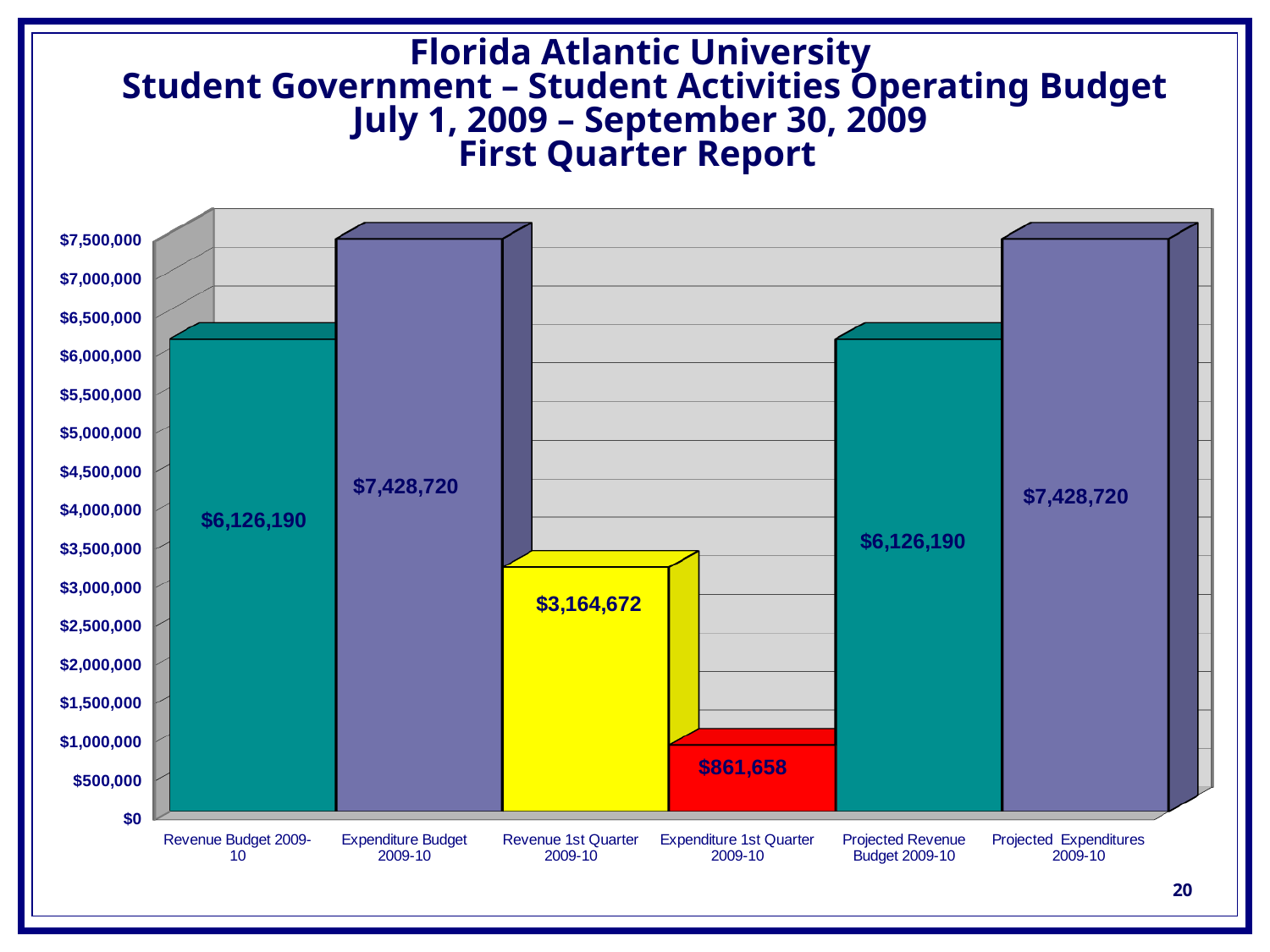
What is the value for Expenditure 1st Quarter 2009-10? $861,658 Which category has the lowest value? Expenditure 1st Quarter 2009-10 What colour is the bar for Revenue 1st Quarter 2009-10? yellow What kind of chart is shown on the slide? bar chart What is the difference between Expenditure Budget 2009-10 and Revenue Budget 2009-10? $1,302,530 What is the value for Projected Expenditures 2009-10? $7,428,720 Which is larger, Revenue 1st Quarter 2009-10 or Expenditure 1st Quarter 2009-10? Revenue 1st Quarter 2009-10 What is the value for Revenue 1st Quarter 2009-10? $3,164,672 Is the value for Expenditure 1st Quarter 2009-10 greater or less than $1,000,000? less How many categories are shown in the chart? 6 What is the difference between Revenue 1st Quarter 2009-10 and Expenditure 1st Quarter 2009-10? $2,303,014 What is the value for Revenue Budget 2009-10? $6,126,190